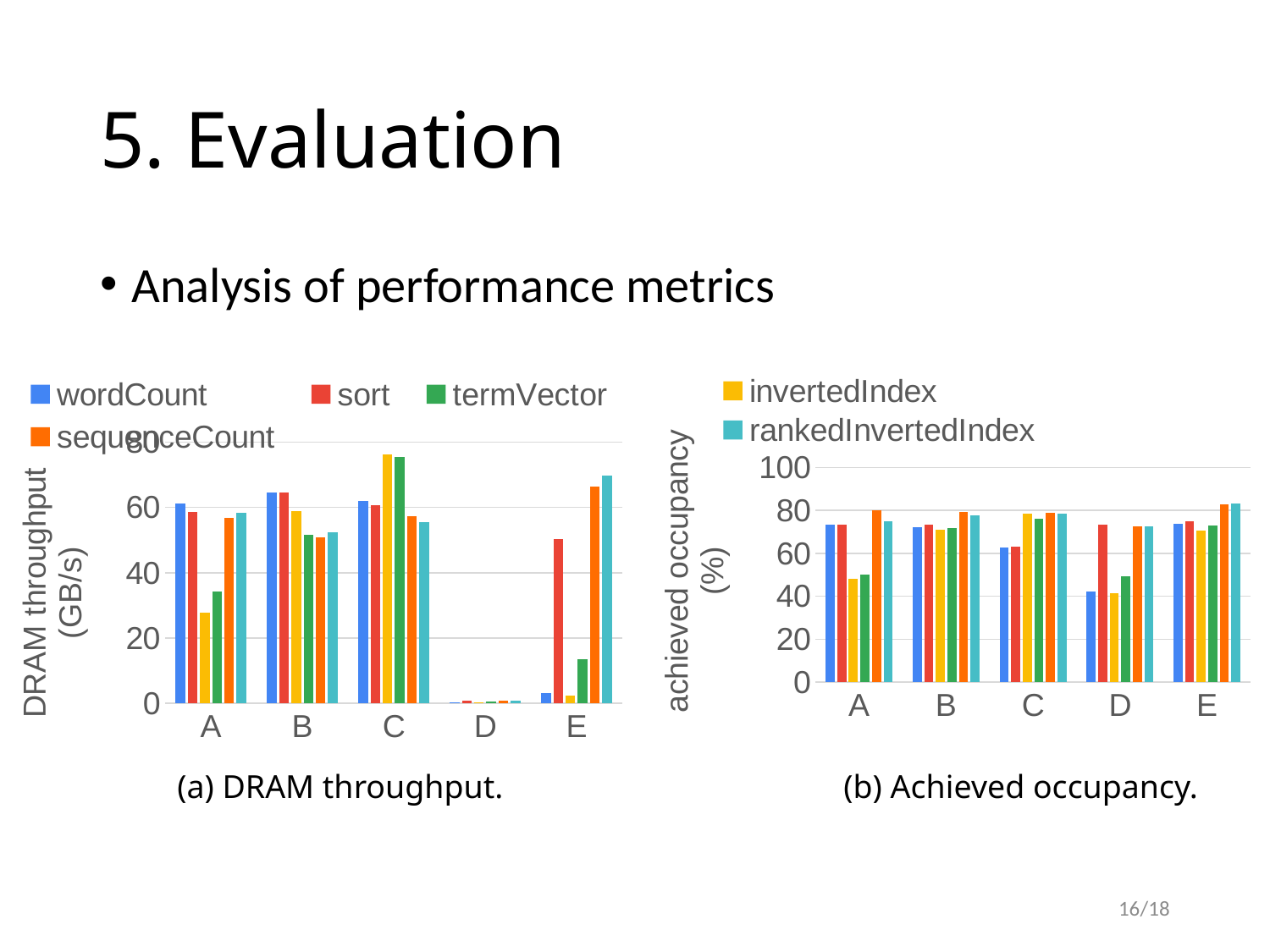
In chart (a) DRAM throughput, is the value for wordCount at category A greater or less than 40? greater In chart (a) DRAM throughput, is the value for sort at category E greater or less than 40? greater In chart (b) Achieved occupancy, is the value for sort at category D greater or less than 60? greater In chart (a) DRAM throughput, at category E, which is larger: sequenceCount or wordCount? sequenceCount In chart (a) DRAM throughput, at category A, which is larger: wordCount or invertedIndex? wordCount In chart (b) Achieved occupancy, at category D, which is larger: sort or invertedIndex? sort What kind of chart is chart (a) DRAM throughput? bar chart In chart (a) DRAM throughput, which category has the lowest values across all series? D What is the y-axis label of chart (b) Achieved occupancy? achieved occupancy (%) How many categories are shown on the x axis of chart (b) Achieved occupancy? 5